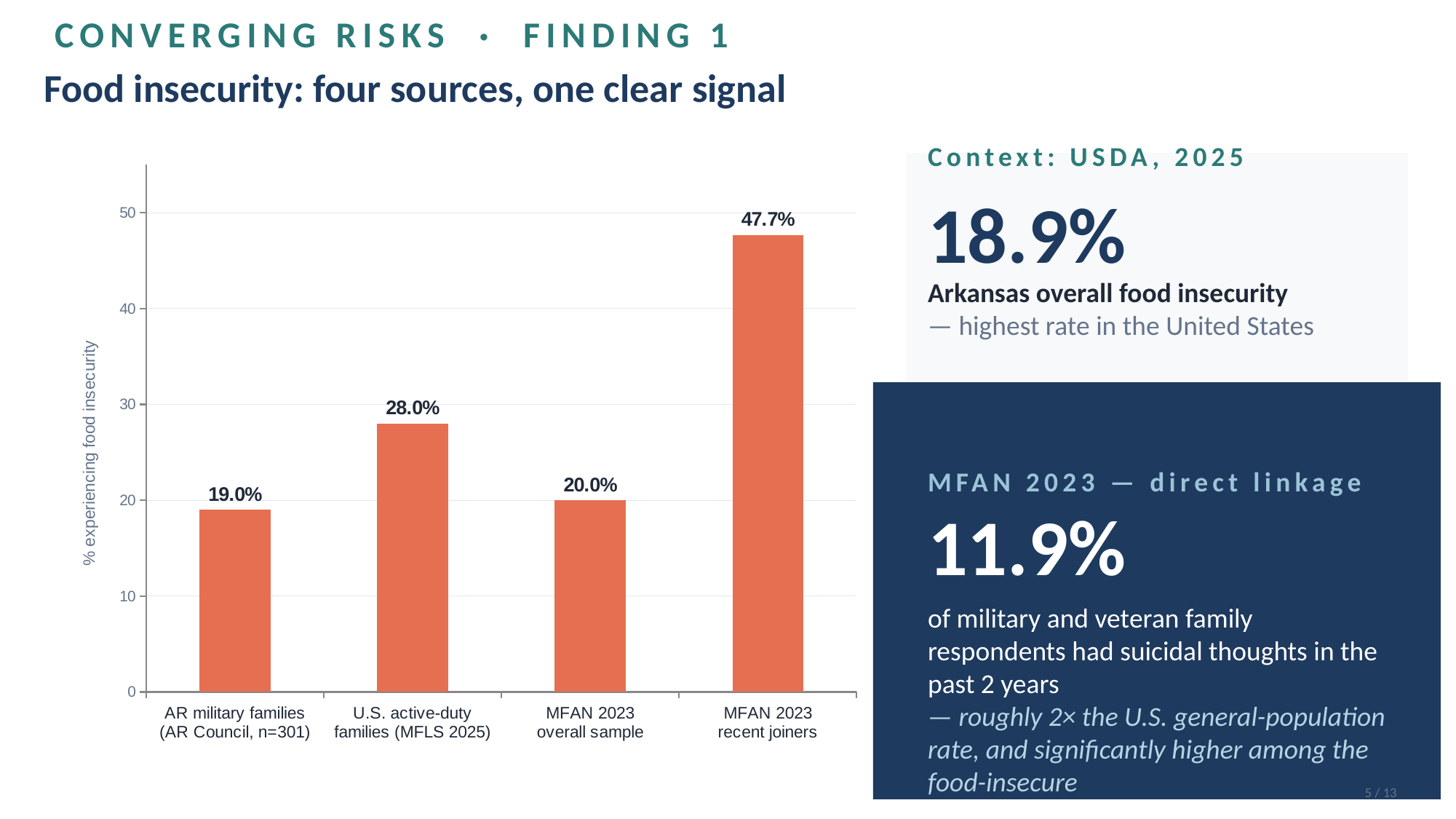
What kind of chart is shown on the slide? Bar chart What is the value for MFAN 2023 recent joiners? 47.7% What is the difference between U.S. active-duty families (MFLS 2025) and AR military families (AR Council, n=301)? 9.0% What is the difference between MFAN 2023 recent joiners and the MFAN 2023 overall sample? 27.7% Which is larger: the value for U.S. active-duty families (MFLS 2025) or the MFAN 2023 overall sample? U.S. active-duty families (MFLS 2025) What is the value for U.S. active-duty families (MFLS 2025)? 28.0% What is the value for the MFAN 2023 overall sample? 20.0% Which category has the lowest percentage experiencing food insecurity? AR military families (AR Council, n=301) Which category has the highest percentage experiencing food insecurity? MFAN 2023 recent joiners Is the value for MFAN 2023 recent joiners greater or less than 40? greater How many categories are shown on the chart? 4 What is the value for AR military families (AR Council, n=301)? 19.0%